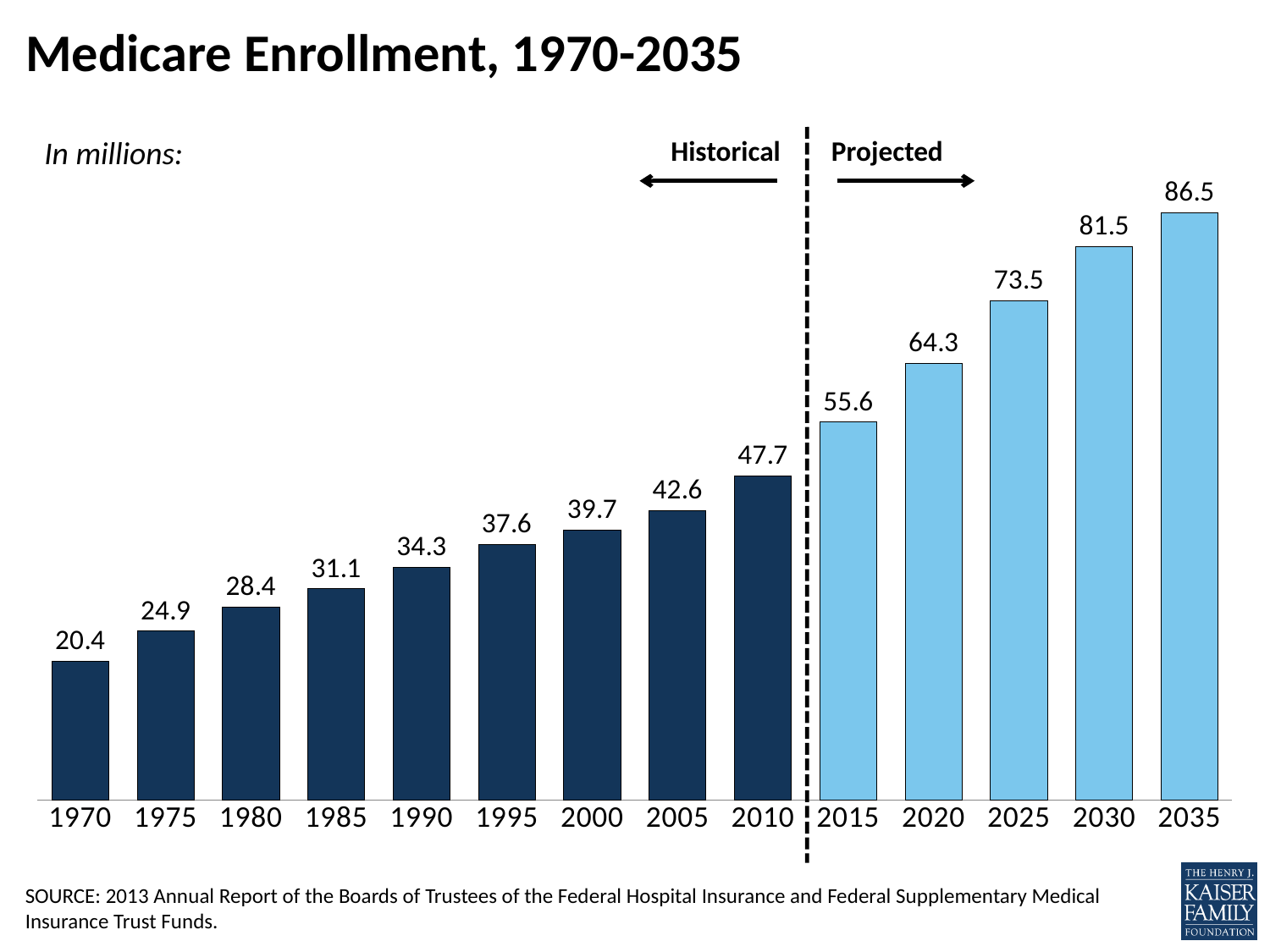
What is the first year labeled as 'Projected' on the chart? 2015 What is the difference between the enrollment values for 2035 and 2010? 38.8 In what units are the enrollment values expressed, according to the chart? Millions Which year has the highest Medicare enrollment on the chart? 2035 What is the Medicare enrollment value shown for 1990? 34.3 What is the difference between the enrollment values for 2015 and 2010? 7.9 Do the enrollment values rise or fall from 1970 to 2035? Rise What kind of chart is shown on the slide? Bar chart What is the projected Medicare enrollment for 2025? 73.5 Which year has a larger enrollment value, 2000 or 2020? 2020 Which year has the lowest Medicare enrollment on the chart? 1970 How many years (bars) are shown on the chart? 14